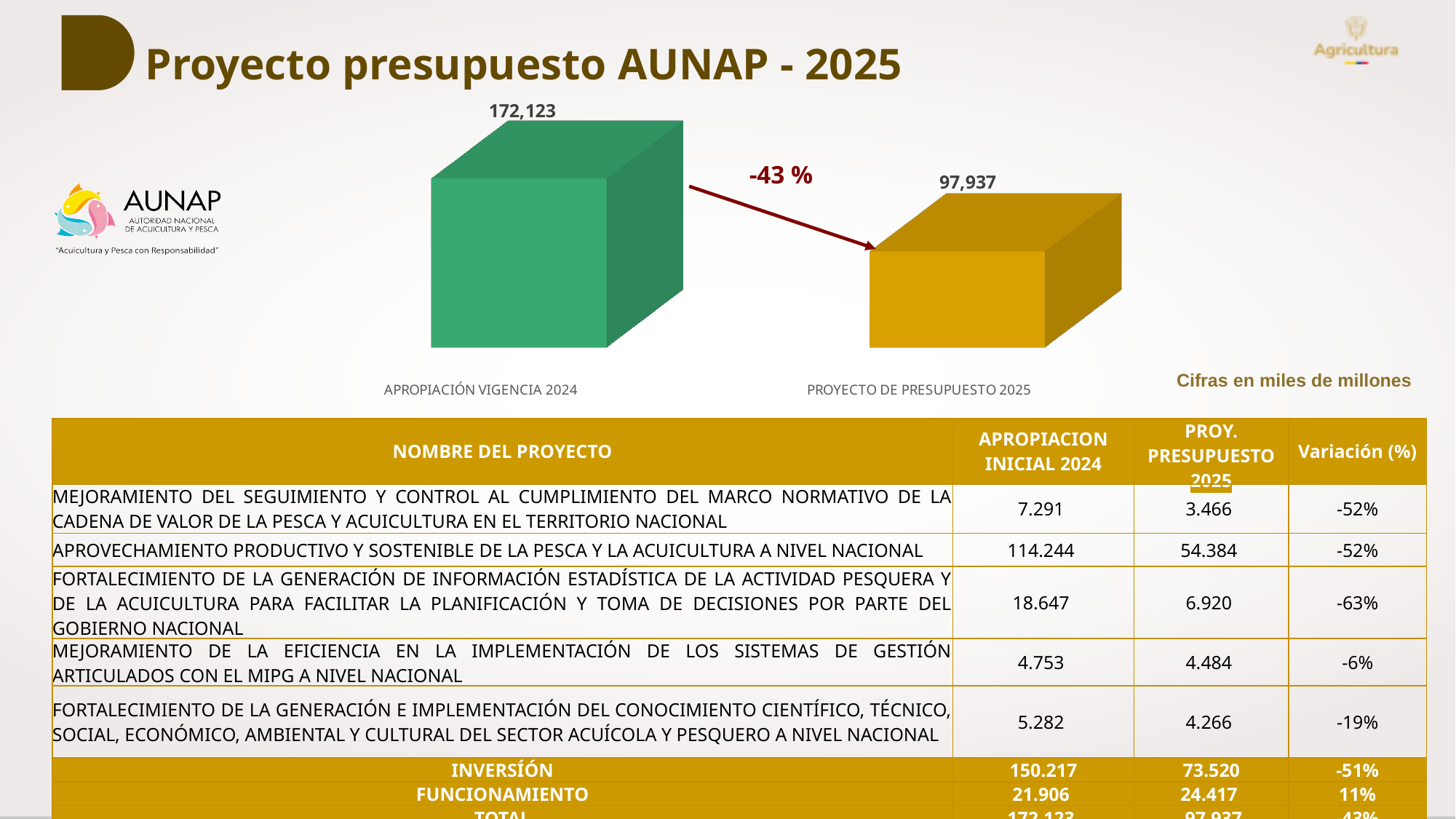
What colour is the bar for PROYECTO DE PRESUPUESTO 2025? Gold/yellow What percentage change is written on the arrow between the two bars? -43 % What kind of chart is shown on the slide? Bar chart What is the difference between the value for APROPIACIÓN VIGENCIA 2024 and the value for PROYECTO DE PRESUPUESTO 2025? 74,186 Do the values in the chart rise or fall from 2024 to 2025? Fall Which category in the chart has the lowest value? PROYECTO DE PRESUPUESTO 2025 How many bars are plotted in the chart? 2 Which category in the chart has the highest value? APROPIACIÓN VIGENCIA 2024 Which is larger in the chart: APROPIACIÓN VIGENCIA 2024 or PROYECTO DE PRESUPUESTO 2025? APROPIACIÓN VIGENCIA 2024 What is the value shown for PROYECTO DE PRESUPUESTO 2025 in the chart? 97,937 What is the value shown for APROPIACIÓN VIGENCIA 2024 in the chart? 172,123